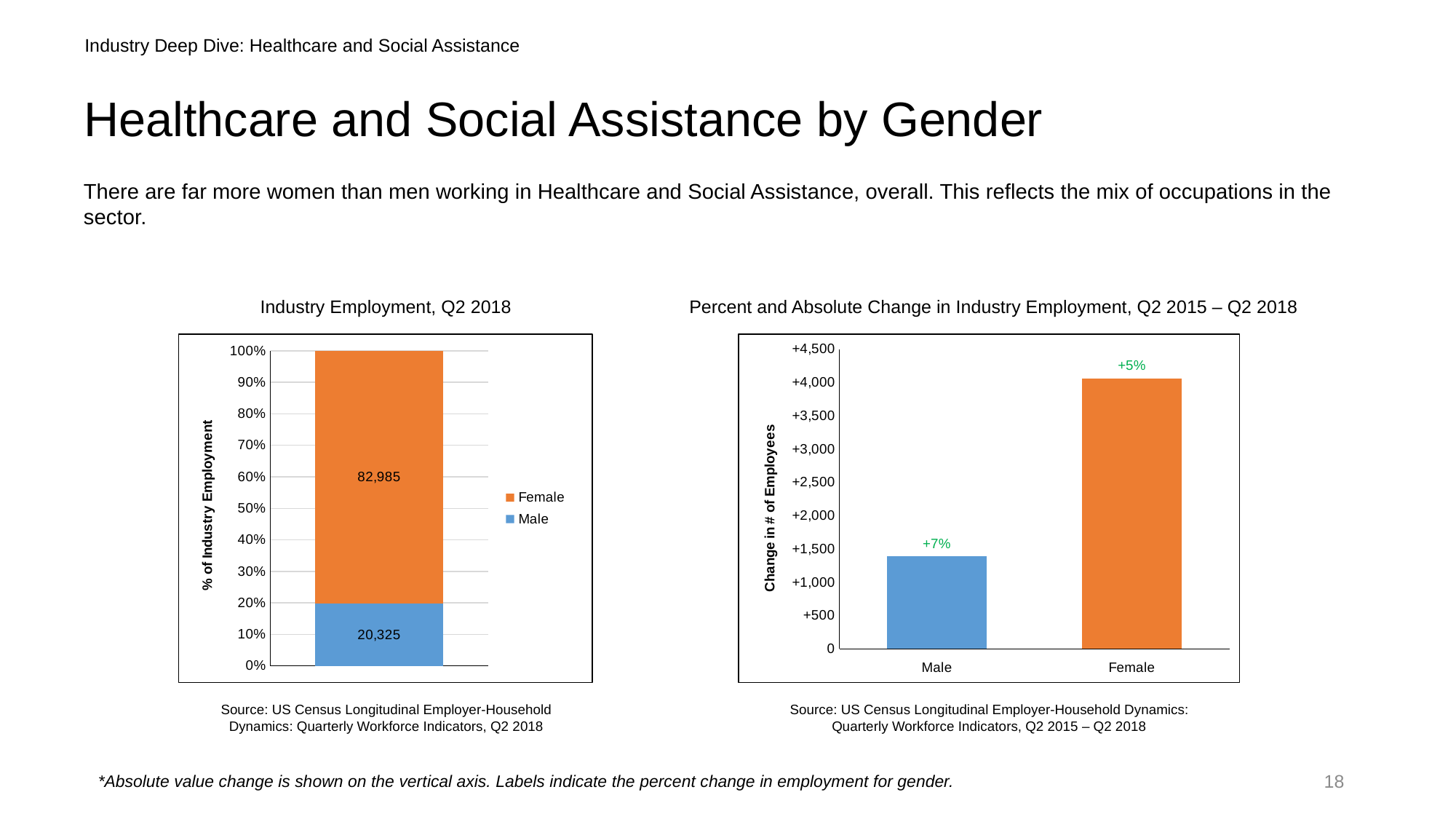
In the 'Percent and Absolute Change in Industry Employment, Q2 2015 – Q2 2018' chart, which category has the highest absolute change? Female In the 'Percent and Absolute Change in Industry Employment, Q2 2015 – Q2 2018' chart, what percent change label is shown for Female? +5% In the 'Industry Employment, Q2 2018' chart, how many series does the legend list? 2 In the 'Percent and Absolute Change in Industry Employment, Q2 2015 – Q2 2018' chart, is the value for Male greater or less than +1,500? less What kind of chart is the 'Percent and Absolute Change in Industry Employment, Q2 2015 – Q2 2018' chart? bar chart In the 'Industry Employment, Q2 2018' chart, what is the difference between the Female and Male values? 62,660 In the 'Industry Employment, Q2 2018' chart, what is the total of the stacked bar? 103,310 In the 'Industry Employment, Q2 2018' chart, what is the value shown for Male? 20,325 In the 'Percent and Absolute Change in Industry Employment, Q2 2015 – Q2 2018' chart, is the value for Female greater or less than +3,500? greater In the 'Industry Employment, Q2 2018' chart, what is the value shown for Female? 82,985 In the 'Industry Employment, Q2 2018' chart, which series is larger, Female or Male? Female In the 'Percent and Absolute Change in Industry Employment, Q2 2015 – Q2 2018' chart, what percent change label is shown for Male? +7%